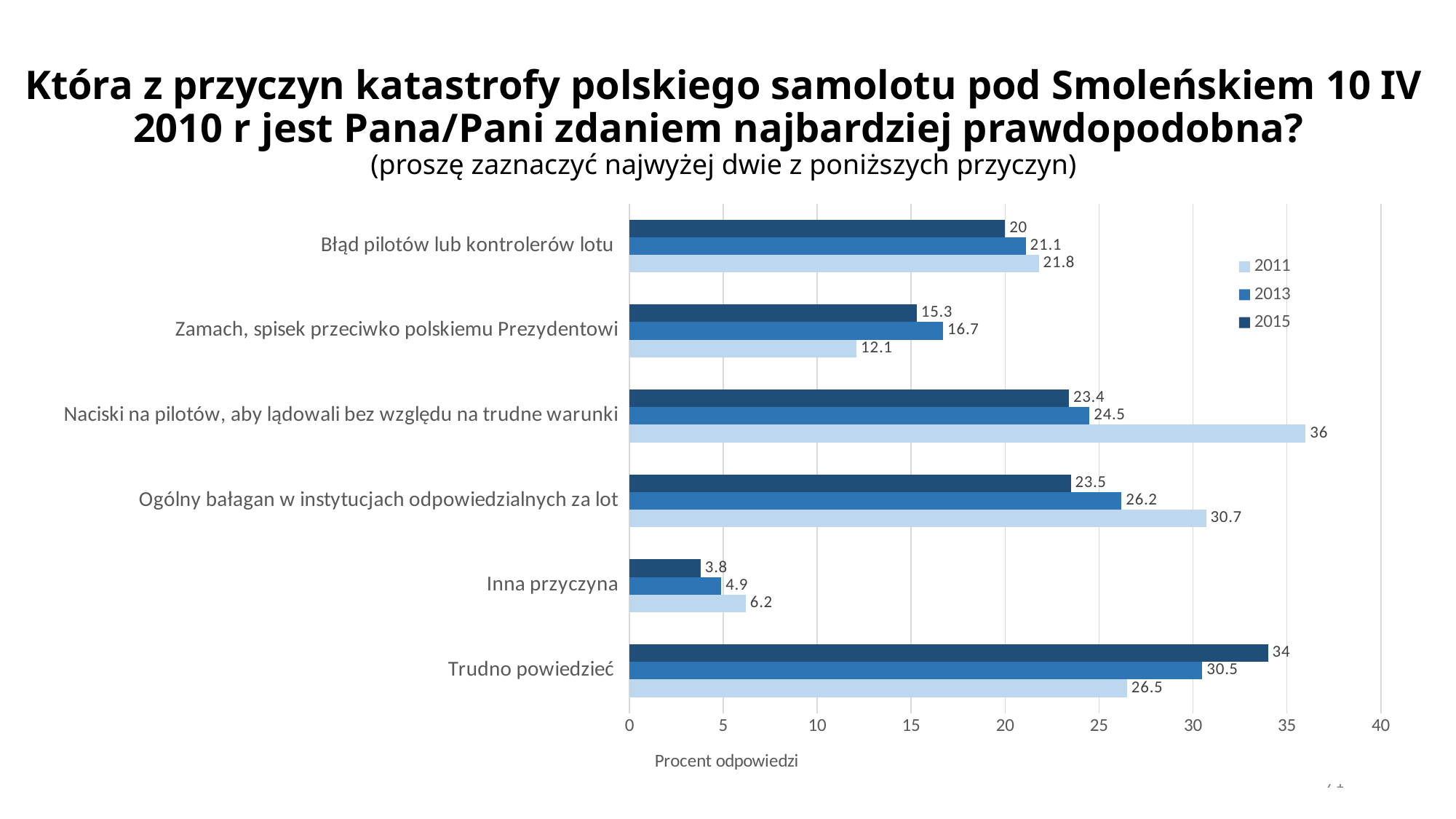
How many series does the legend list? 3 Which category has the highest 2015 value? Trudno powiedzieć What kind of chart is shown on the slide? Bar chart Is the 2013 value for "Trudno powiedzieć" greater or less than 30? greater Which category has the lowest 2011 value? Inna przyczyna What is the 2011 value for "Naciski na pilotów, aby lądowali bez względu na trudne warunki"? 36 How many categories are shown on the chart? 6 Which is larger for "Ogólny bałagan w instytucjach odpowiedzialnych za lot": the 2011 value or the 2013 value? 2011 What is the 2015 value for "Trudno powiedzieć"? 34 What is the difference between the 2011 and 2015 values for "Naciski na pilotów, aby lądowali bez względu na trudne warunki"? 12.6 What is the 2013 value for "Zamach, spisek przeciwko polskiemu Prezydentowi"? 16.7 What is the label of the horizontal axis? Procent odpowiedzi